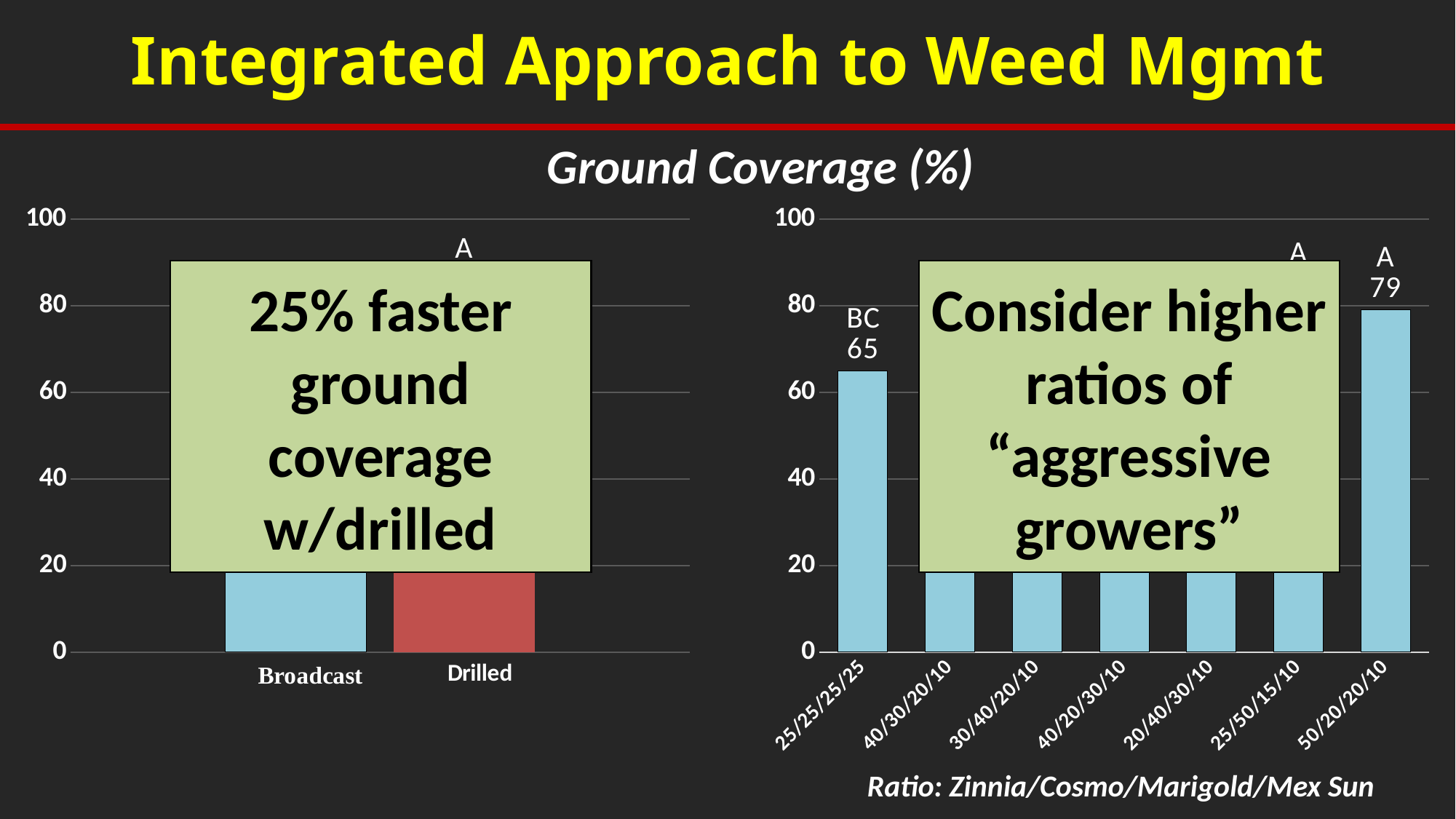
What kind of chart is the left chart (Broadcast vs Drilled)? bar chart What is the shared title shown above the two charts? Ground Coverage (%) On the right chart, which has the larger value: 25/25/25/25 or 50/20/20/10? 50/20/20/10 What kind of chart is the right chart (the ratio chart)? bar chart On the left chart, what colour is the Drilled bar? red On the right chart, is the value for 50/20/20/10 greater or less than 80? less On the right chart, what is the difference between the values for 50/20/20/10 and 25/25/25/25? 14 On the right chart, what is the ground coverage value for the 50/20/20/10 ratio? 79 How many ratio categories are shown on the x axis of the right chart? 7 How many categories are shown on the x axis of the left chart? 2 On the right chart, is the value for 25/25/25/25 greater or less than 60? greater On the right chart, what is the ground coverage value for the 25/25/25/25 ratio? 65